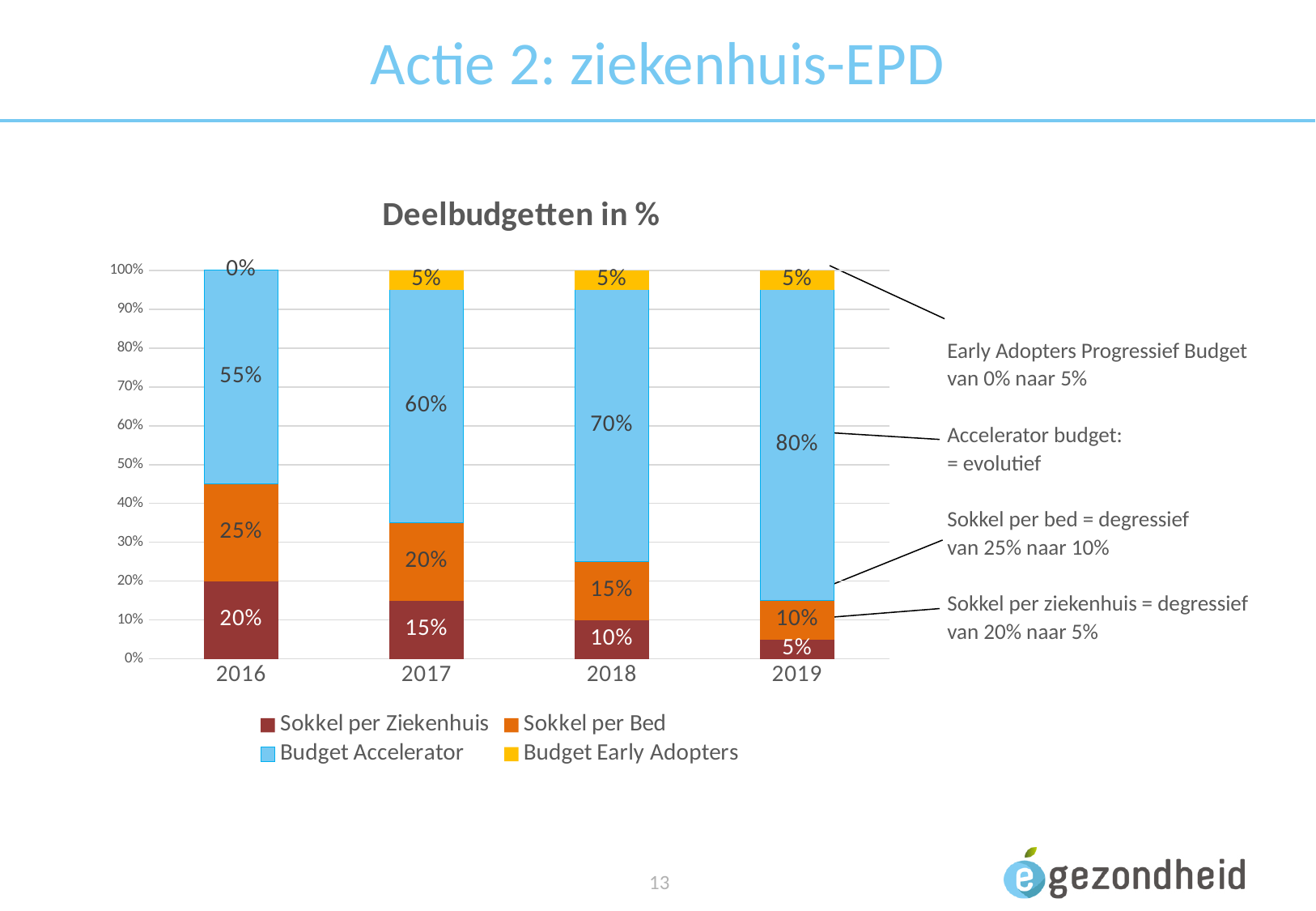
How many series does the legend list? 4 What kind of chart is shown? Stacked bar chart In which year is the Budget Accelerator value highest? 2019 What is the value for Budget Early Adopters in 2016? 0% Does the Sokkel per Bed value rise or fall from 2016 to 2019? Fall What is the difference between the Budget Accelerator values for 2019 and 2016? 25% Which is larger: Sokkel per Bed in 2017 or Sokkel per Bed in 2018? Sokkel per Bed in 2017 How many years are shown on the x axis? 4 What is the value for Budget Accelerator in 2018? 70% What is the value for Sokkel per Ziekenhuis in 2016? 20% What is the value for Sokkel per Bed in 2019? 10% In which year is the Sokkel per Ziekenhuis value lowest? 2019